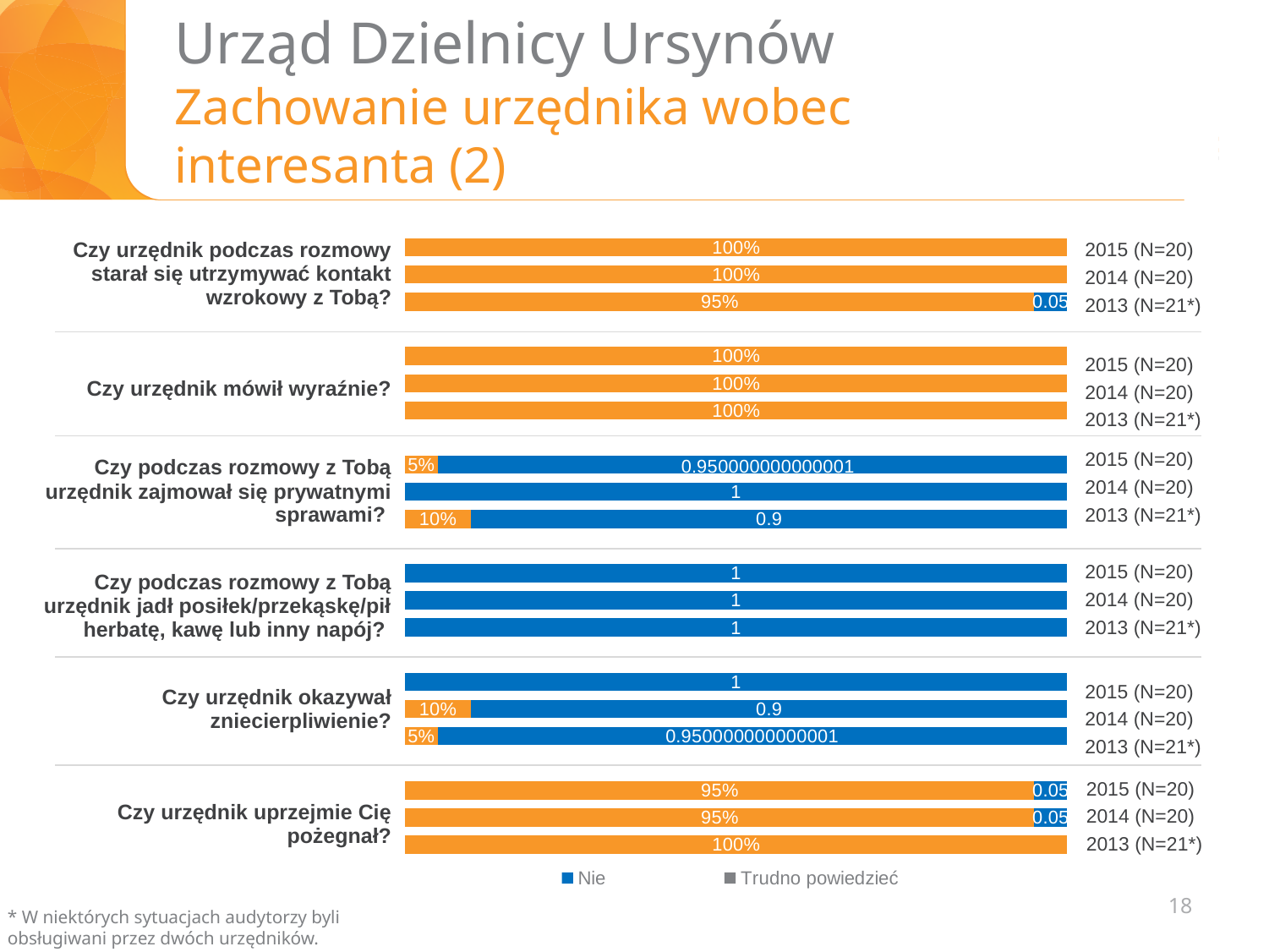
For "Czy podczas rozmowy z Tobą urzędnik zajmował się prywatnymi sprawami?", which year has the larger orange segment, 2015 (N=20) or 2013 (N=21*)? 2013 (N=21*) What kind of chart is shown on the slide? bar chart What value is printed on the orange segment of the 2013 (N=21*) bar for "Czy podczas rozmowy z Tobą urzędnik zajmował się prywatnymi sprawami?"? 10% What value is printed on the 2013 (N=21*) bar for "Czy urzędnik uprzejmie Cię pożegnał?"? 100% Which entries does the legend list? Nie, Trudno powiedzieć What value is printed on the orange segment of the 2015 (N=20) bar for "Czy urzędnik uprzejmie Cię pożegnał?"? 95% What value is printed on the 2015 (N=20) bar for "Czy urzędnik mówił wyraźnie?"? 100% What value is printed on the blue segment of the 2015 (N=20) bar for "Czy podczas rozmowy z Tobą urzędnik zajmował się prywatnymi sprawami?"? 0.950000000000001 What value is printed on the blue segment of the 2014 (N=20) bar for "Czy urzędnik okazywał zniecierpliwienie?"? 0.9 How many years (bars) are shown for each survey question? 3 How many survey questions (bar groups) are shown in the chart? 6 What value is printed at the right end of the 2013 (N=21*) bar for "Czy urzędnik podczas rozmowy starał się utrzymywać kontakt wzrokowy z Tobą?"? 0.05